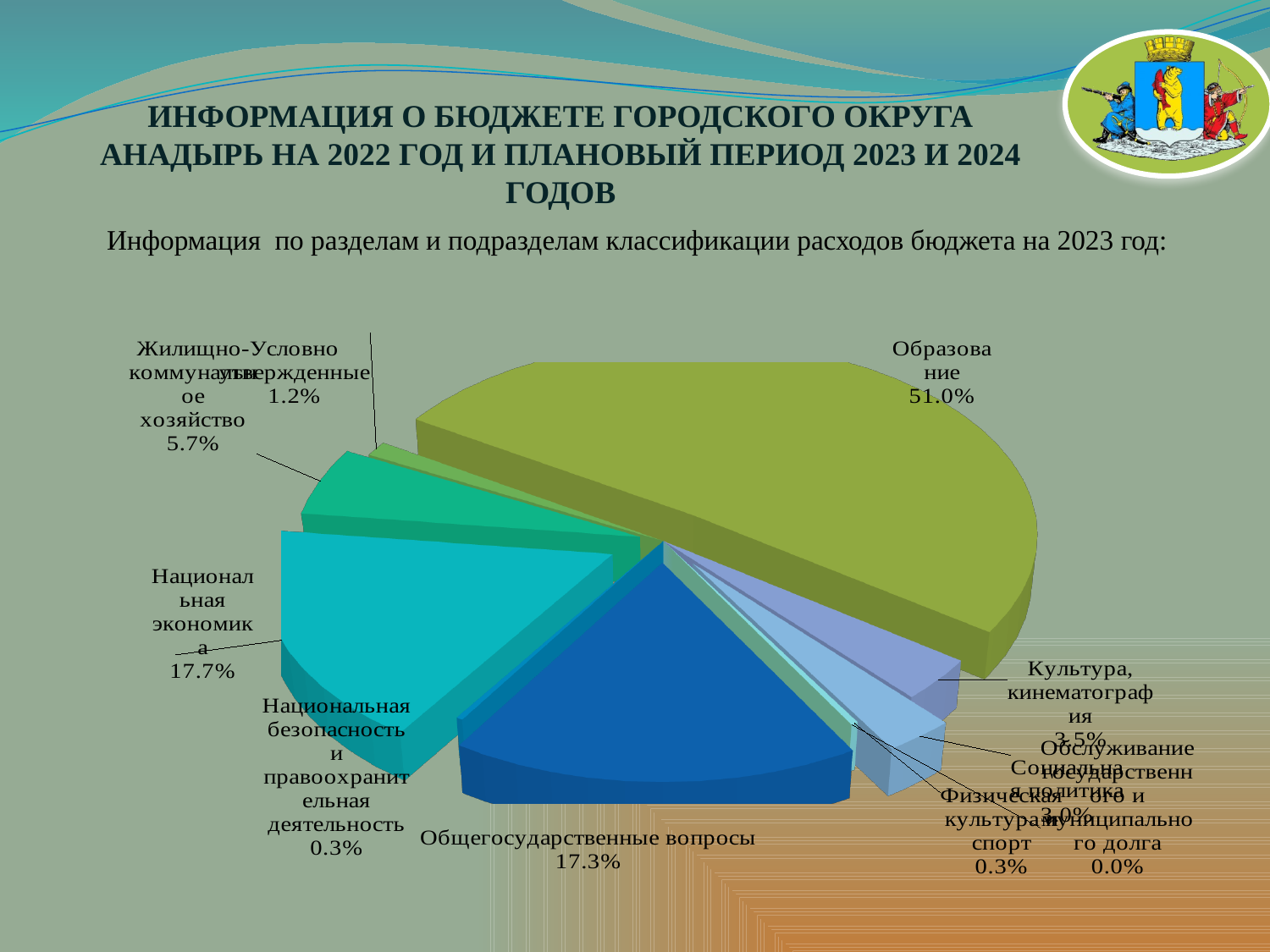
Which category has the largest share of the pie? Образование Which is larger: the share of Образование or the share of Национальная экономика? Образование What is the value shown for Условно утвержденные? 1.2% Which category has the smallest share of the pie? Обслуживание государственного и муниципального долга What is the value shown for Общегосударственные вопросы? 17.3% What share of the 2023 budget expenditures goes to Образование? 51.0% What kind of chart is shown on the slide? pie chart What is the value shown for Национальная экономика? 17.7% What is the difference between the shares of Национальная экономика and Общегосударственные вопросы? 0.4% How many categories (slices) does the pie chart have? 10 What is the value shown for Жилищно-коммунальное хозяйство? 5.7% What is the value shown for Культура, кинематография? 3.5%